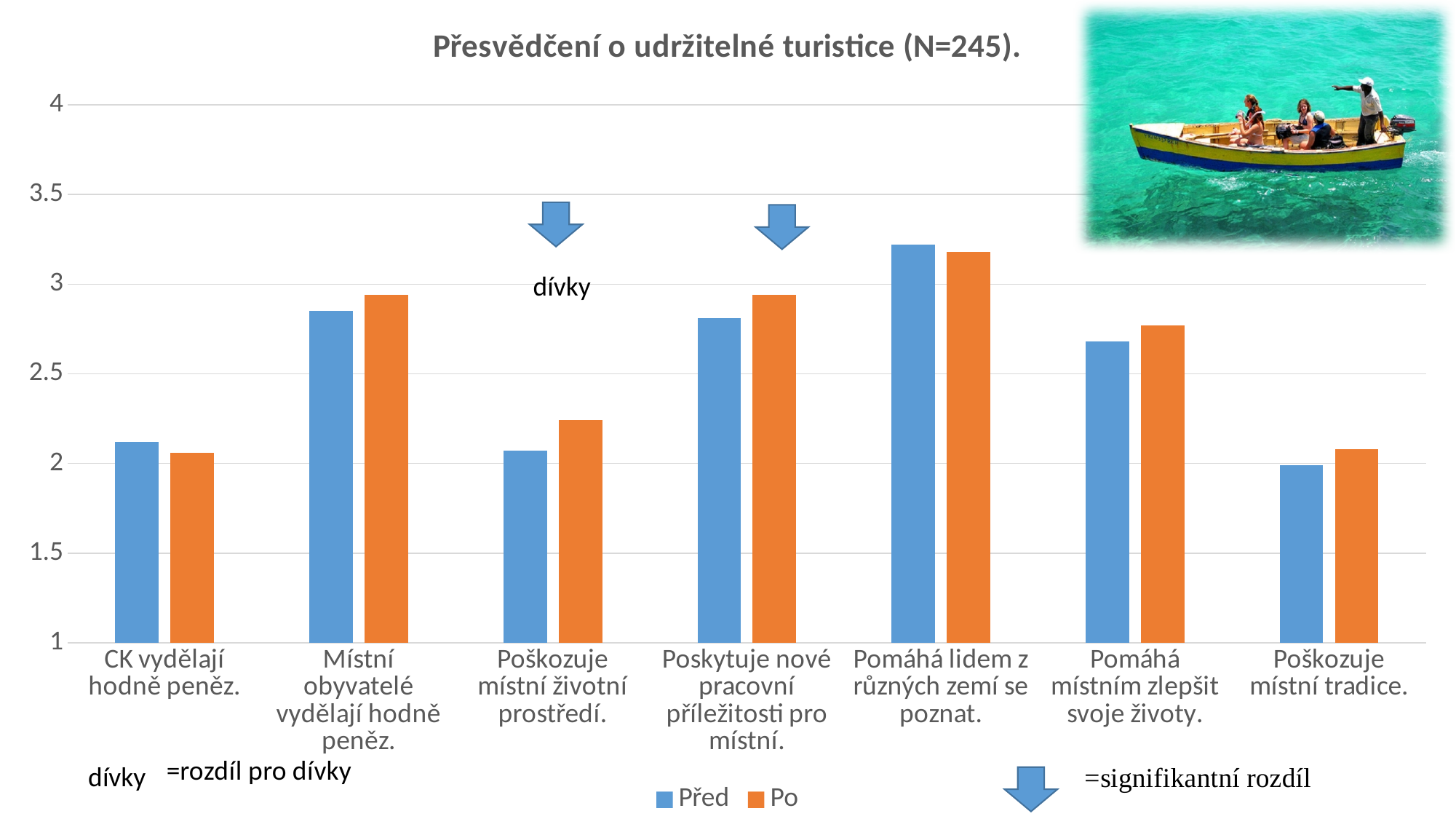
What is the title of the chart? Přesvědčení o udržitelné turistice (N=245). Which category has the highest Po value? Pomáhá lidem z různých zemí se poznat. For "Poškozuje místní životní prostředí.", which is larger, the Před value or the Po value? Po Is the Před value for "CK vydělají hodně peněz." greater or less than 2? greater Which category has the highest Před value? Pomáhá lidem z různých zemí se poznat. Is the Před value for "Pomáhá lidem z různých zemí se poznat." greater or less than 3? greater How many series does the chart legend list? 2 How many categories are shown on the x axis of the chart? 7 Is the Po value for "Poškozuje místní životní prostředí." greater or less than 2? greater What are the two series named in the chart legend? Před and Po What kind of chart is shown on the slide? bar chart